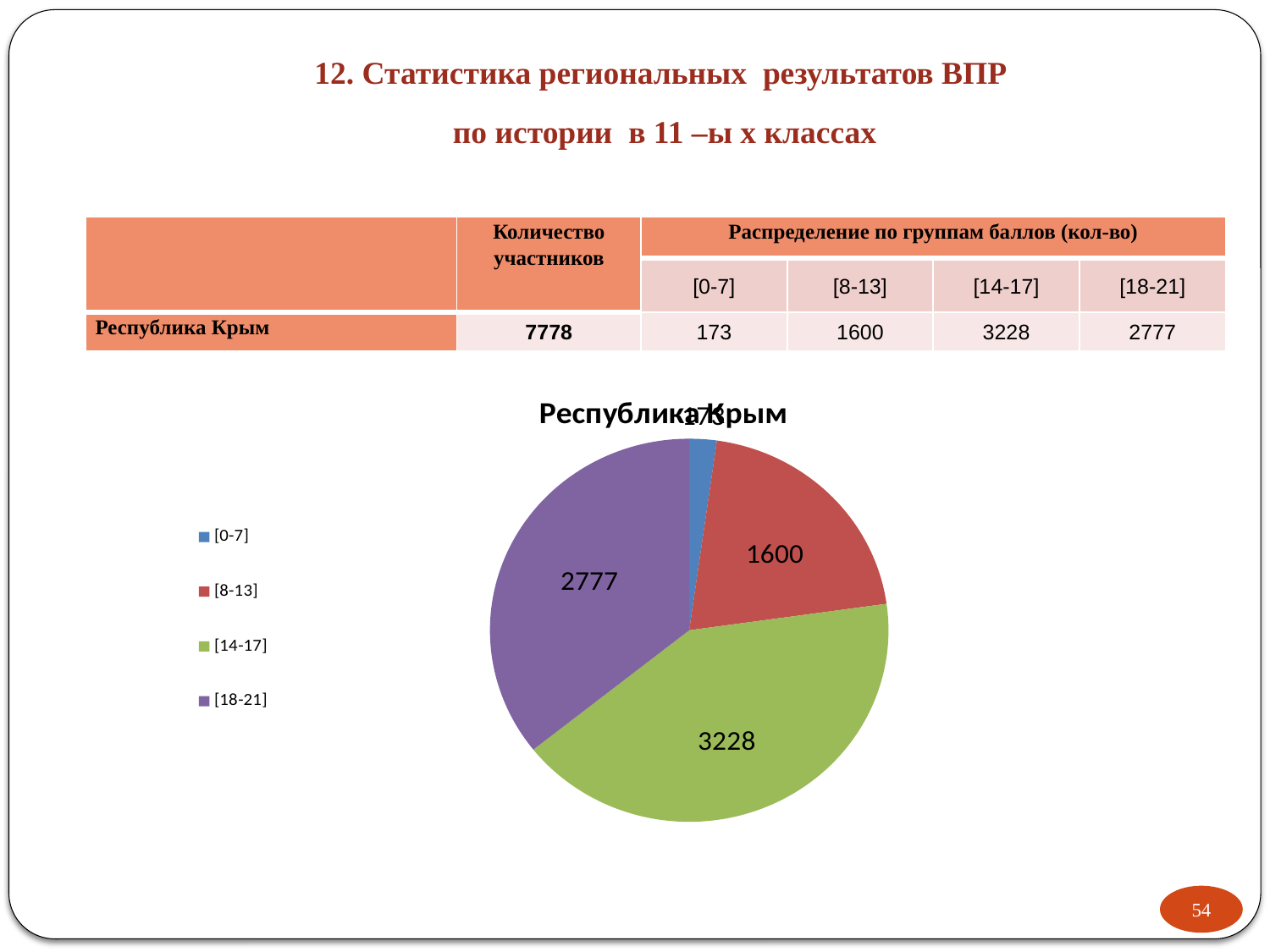
What is the value of the [18-21] slice in the pie chart? 2777 How many entries does the legend of the pie chart list? 4 Which score group has the largest slice in the pie chart? [14-17] What is the value of the [14-17] slice in the pie chart? 3228 How many slices does the pie chart have? 4 Which colour represents the [14-17] group in the pie chart? green What is the difference between the [14-17] and [18-21] values in the pie chart? 451 What is the title of the pie chart? Республика Крым Which is larger in the pie chart, the [8-13] slice or the [18-21] slice? [18-21] What kind of chart is shown on the slide? pie chart Which score group has the smallest slice in the pie chart? [0-7] What is the value of the [8-13] slice in the pie chart? 1600